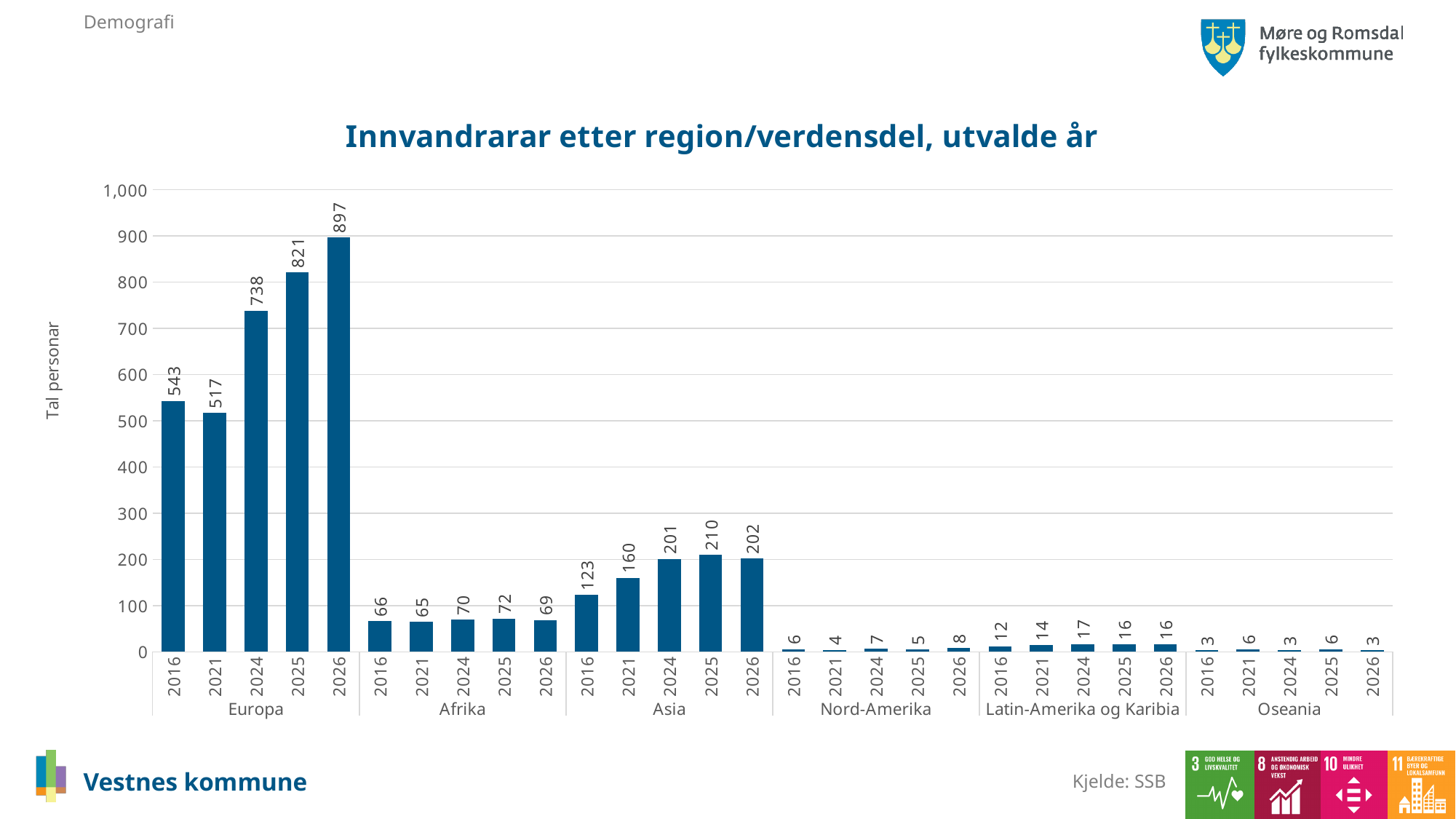
How many regions are shown on the x axis? 6 What is the title of the chart? Innvandrarar etter region/verdensdel, utvalde år What is the difference between the Europa values for 2026 and 2016? 354 What is the value for Nord-Amerika in 2024? 7 What kind of chart is shown on the slide? Bar chart Which region has the highest bar on the chart? Europa What is the value for Asia in 2021? 160 Which year has the lowest value for Europa? 2021 Is the value for Europa in 2024 greater or less than 700? greater What is the value for Afrika in 2025? 72 Which is larger: Asia in 2025 or Asia in 2026? Asia in 2025 What is the value for Europa in 2026? 897